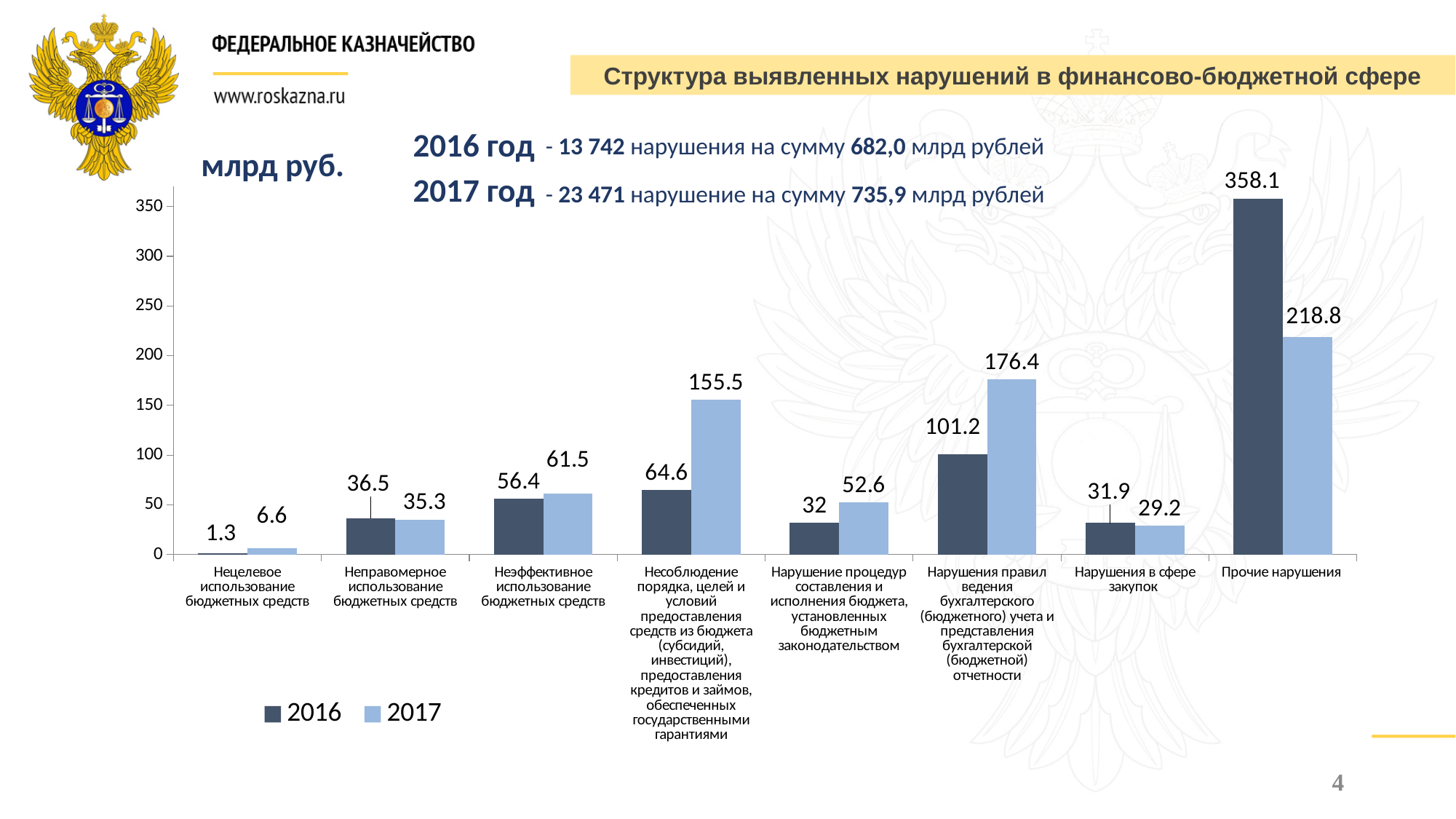
What is the 2016 value for "Нарушения в сфере закупок"? 31.9 How many series does the legend list? 2 What is the 2017 value for "Прочие нарушения"? 218.8 What unit is indicated for the values on the chart? млрд руб. Which category has the highest 2016 value? Прочие нарушения What type of chart is shown on the slide? bar chart What is the 2017 value for "Нарушения правил ведения бухгалтерского (бюджетного) учета и представления бухгалтерской (бюджетной) отчетности"? 176.4 What is the difference between the 2017 and 2016 values for "Несоблюдение порядка, целей и условий предоставления средств из бюджета"? 90.9 How many categories are shown on the x axis of the chart? 8 Is the 2016 value for "Прочие нарушения" greater or less than 300? greater For "Неправомерное использование бюджетных средств", which year has the larger value, 2016 or 2017? 2016 Which category has the lowest 2017 value? Нецелевое использование бюджетных средств